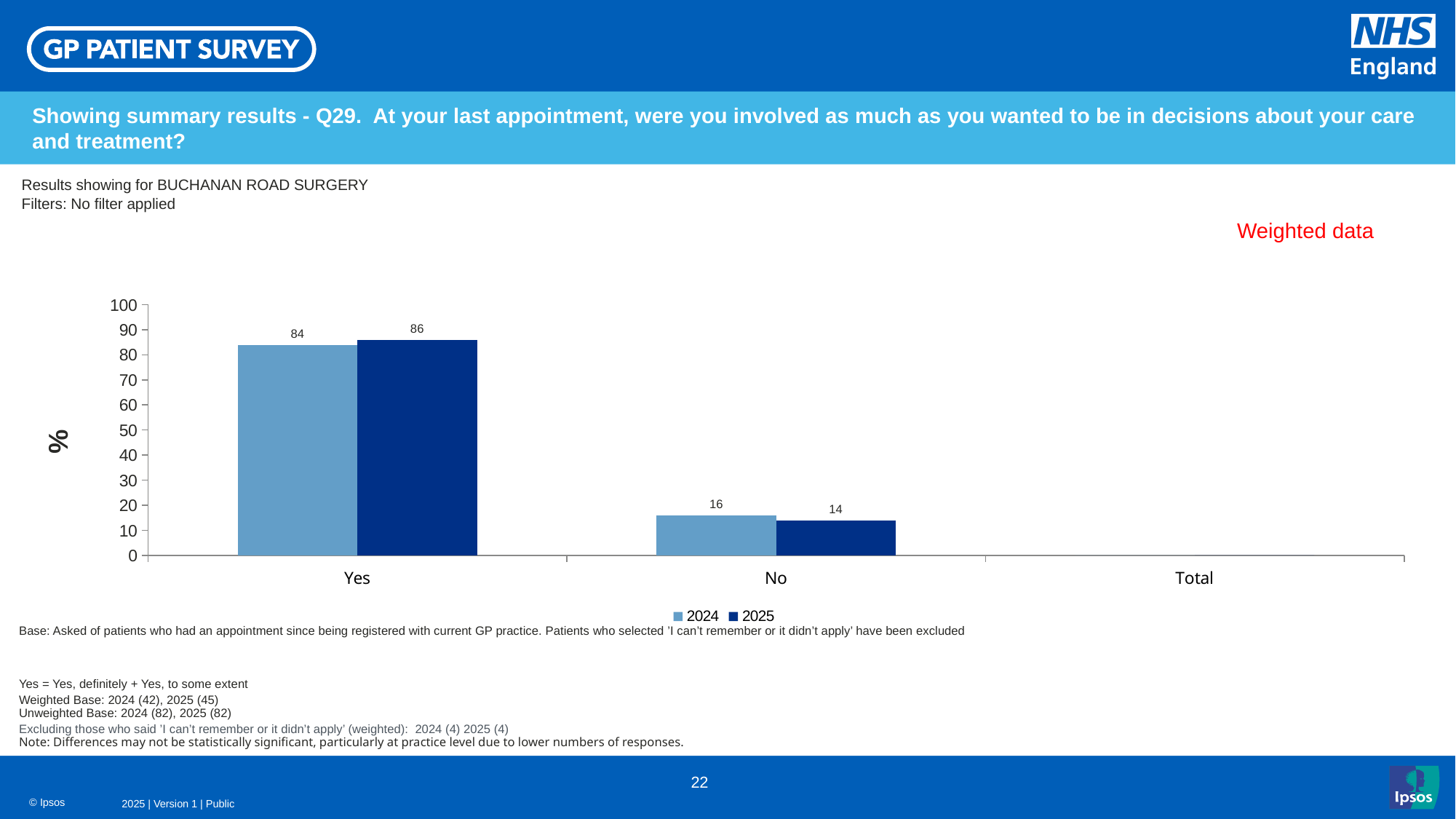
What is the difference between the 2025 and 2024 values for Yes? 2 What is the value for No in 2025? 14 Which is larger, the 2024 value for Yes or the 2025 value for Yes? 2025 Which category has the lowest value in the 2024 series? No What kind of chart is shown on the slide? Bar chart What is the value for Yes in 2025? 86 How many series does the legend list? 2 What is the value for No in 2024? 16 What is the value for Yes in 2024? 84 What is the label on the vertical axis? % Which category has the highest value in the 2025 series? Yes What is the difference between the 2024 and 2025 values for No? 2